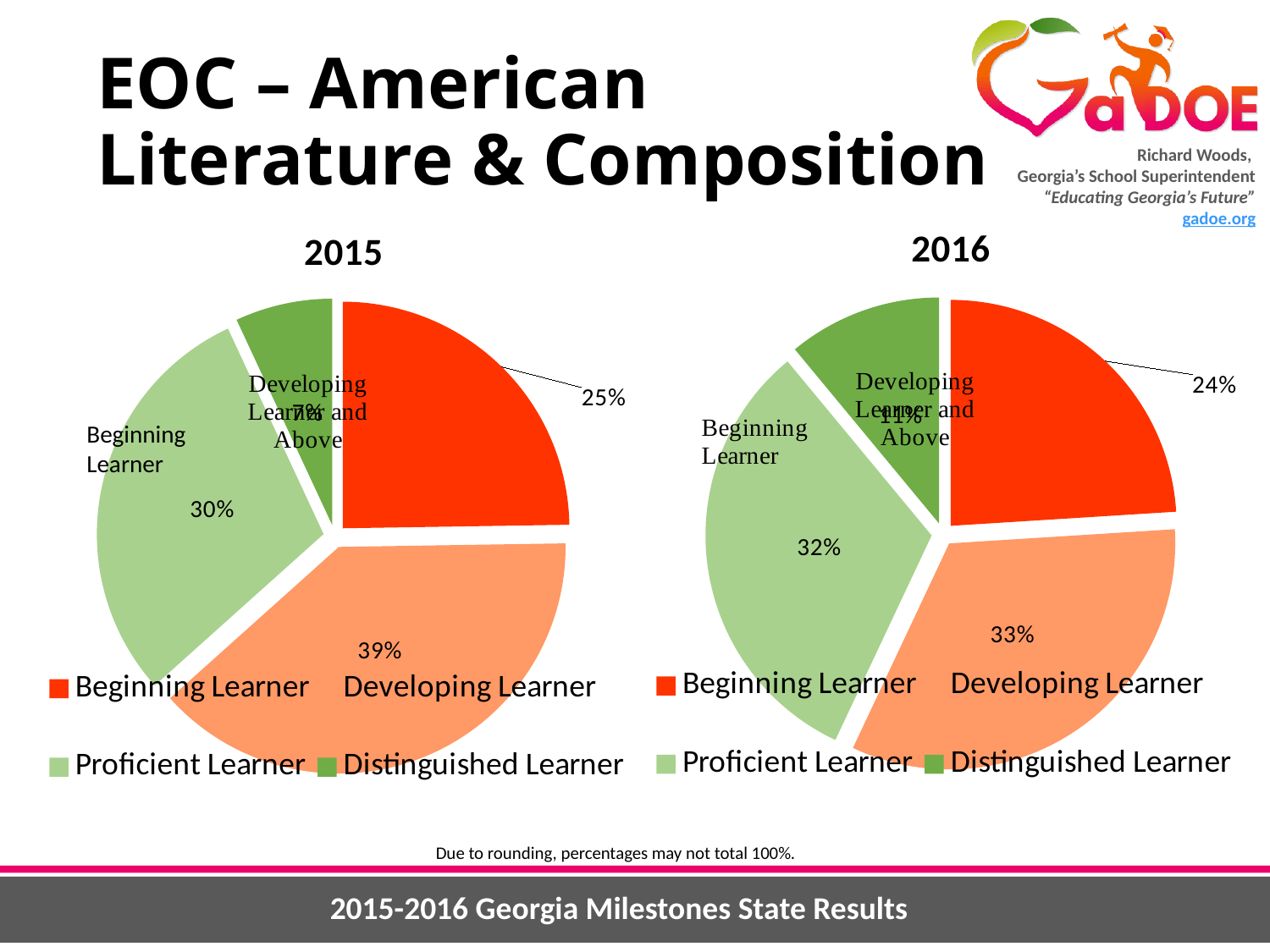
In the 2016 pie chart, what percentage is shown for Beginning Learner? 24% In the 2015 pie chart, what percentage is shown for Developing Learner? 39% In the 2015 pie chart, what percentage is shown for Beginning Learner? 25% How many categories does the legend of the 2016 pie chart list? 4 In the 2016 pie chart, which category has the smallest share? Distinguished Learner In the 2015 pie chart, how many percentage points larger is Developing Learner than Beginning Learner? 14 percentage points In the 2016 pie chart, what percentage is shown for Developing Learner? 33% What kind of chart is used to show the 2015 and 2016 results? Pie chart In the 2015 pie chart, which category has the largest share? Developing Learner In the 2015 pie chart, what percentage is shown for Proficient Learner? 30% In the 2015 pie chart, which category has the smallest share? Distinguished Learner In the 2016 pie chart, what percentage is shown for Proficient Learner? 32%